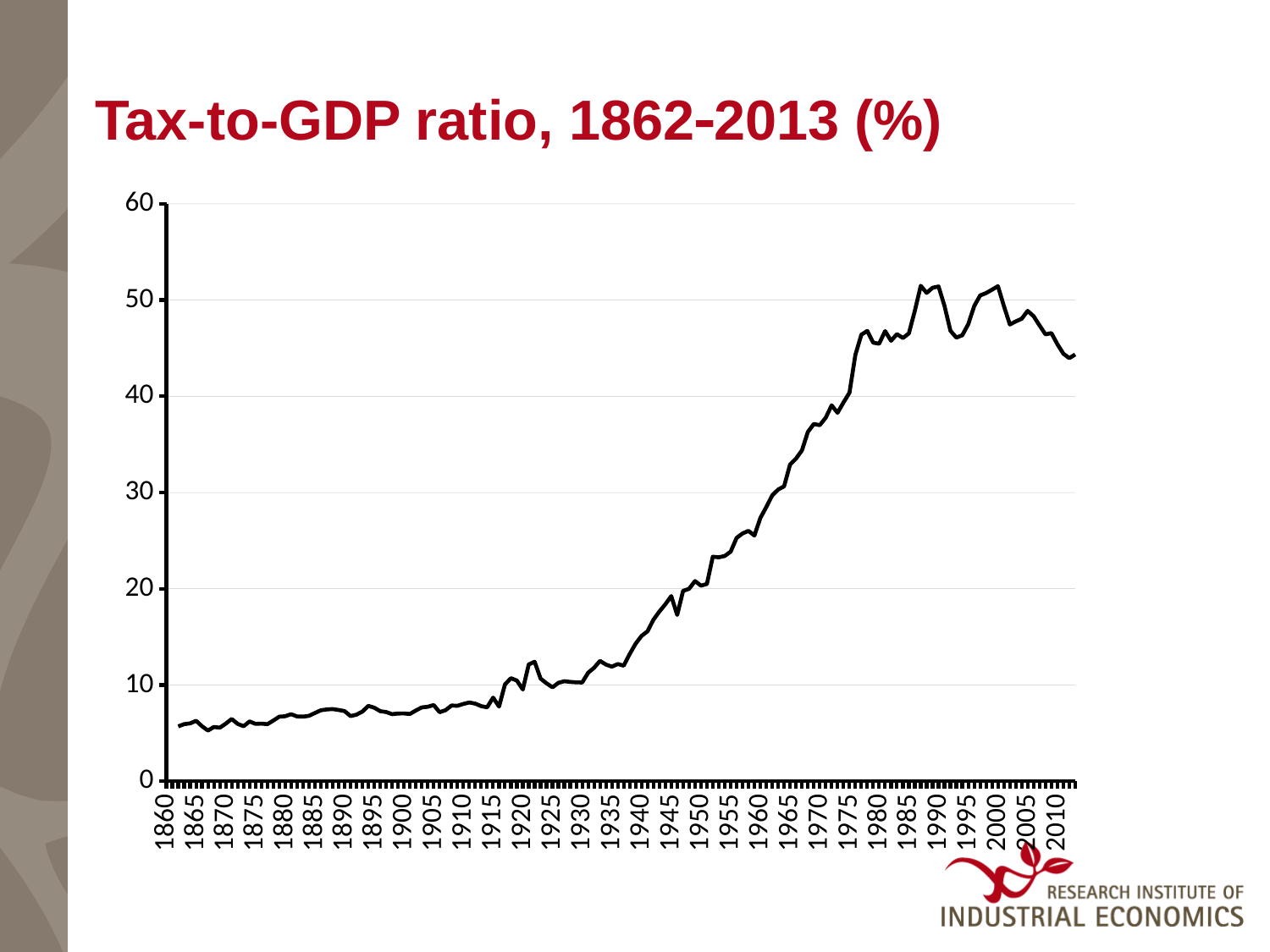
Does the tax-to-GDP ratio rise or fall between 2000 and 2013? fall Is the tax-to-GDP ratio lower at the start of the series (1860s) or at the end (2010s)? 1860s How many lines are plotted on the chart? 1 Is the tax-to-GDP ratio in 1990 greater or less than 40? greater Is the tax-to-GDP ratio in 2010 greater or less than 40? greater Is the tax-to-GDP ratio in 1960 greater or less than 20? greater Which year has the larger tax-to-GDP ratio, 1960 or 1980? 1980 What is the title of the chart? Tax-to-GDP ratio, 1862-2013 (%) What is the highest value shown on the vertical axis? 60 What kind of chart is shown on the slide? line chart Overall, does the tax-to-GDP ratio rise or fall from 1860 to 2013? rise